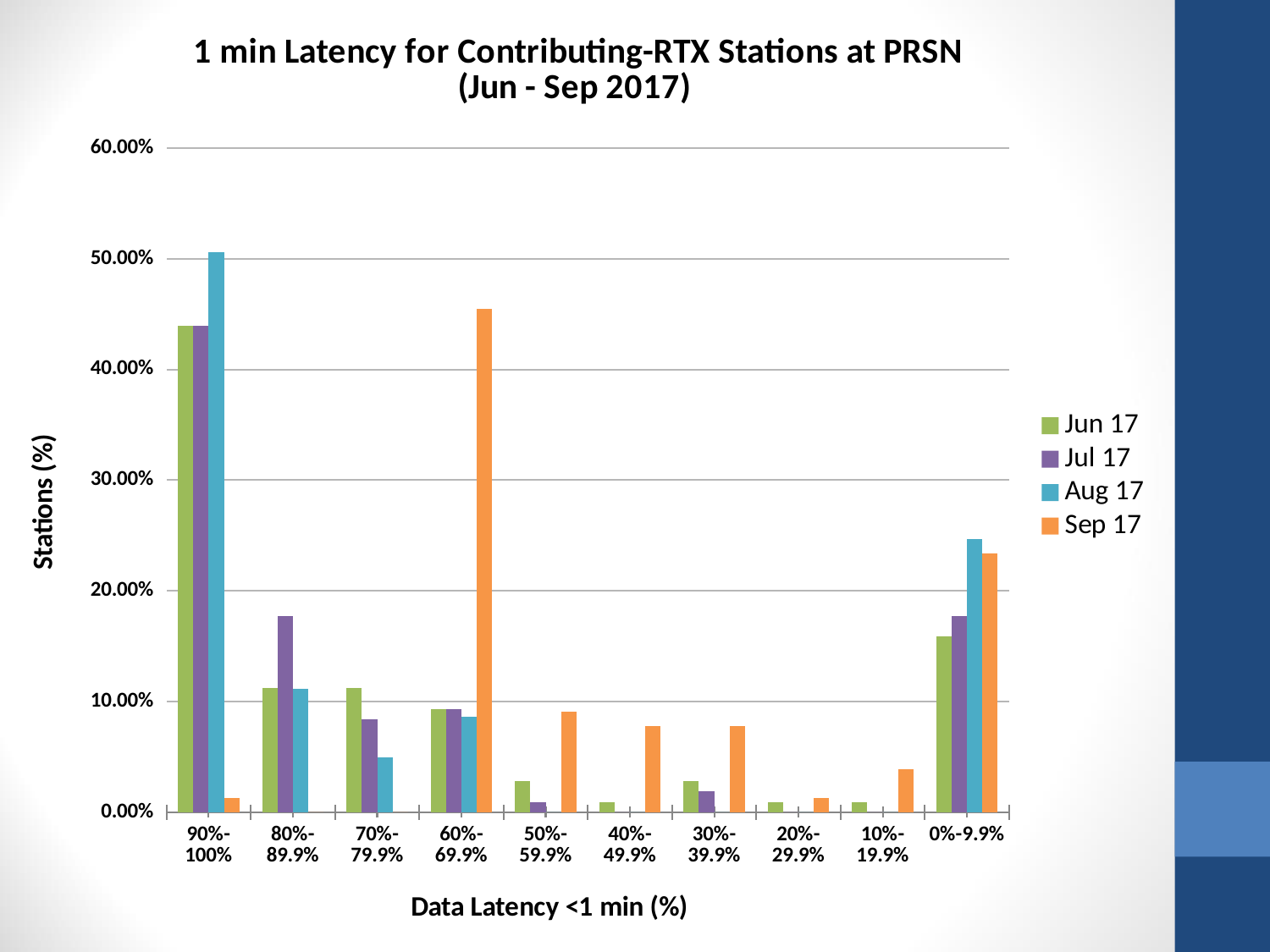
Is the Sep 17 value for 60%-69.9% greater or less than 40.00%? greater What is the title of the vertical axis? Stations (%) Is the Aug 17 value for 90%-100% greater or less than 40.00%? greater In which latency category is the Aug 17 value highest? 90%-100% What kind of chart is shown on the slide? bar chart How many series does the legend list? 4 Is the Jun 17 value for 0%-9.9% greater or less than 20.00%? less For the 0%-9.9% category, which is larger: Jun 17 or Aug 17? Aug 17 How many latency categories are shown on the x axis? 10 In which latency category is the Sep 17 value highest? 60%-69.9% For the 90%-100% category, which is larger: Jun 17 or Sep 17? Jun 17 For the 80%-89.9% category, which is larger: Jun 17 or Jul 17? Jul 17